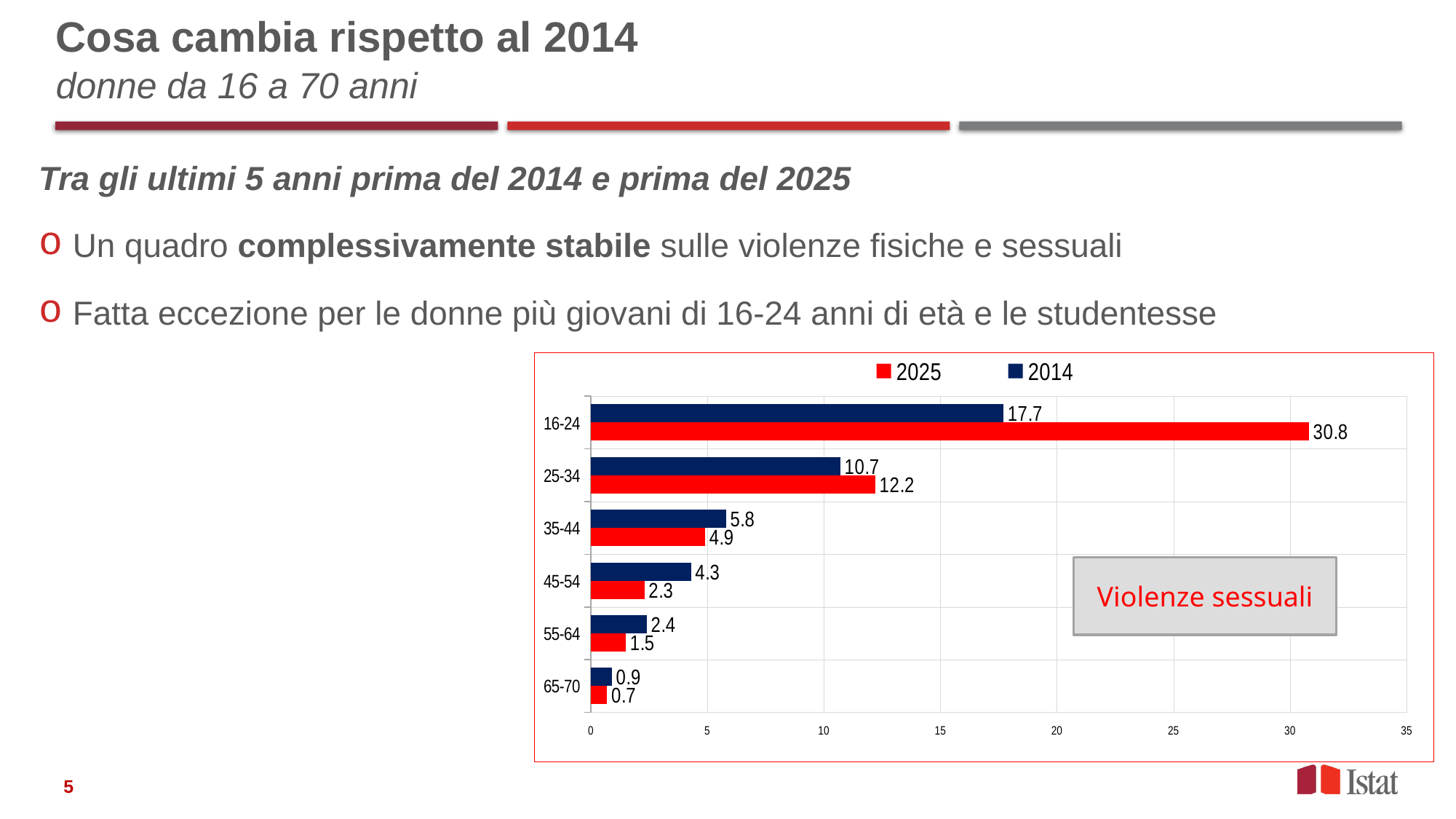
What is the difference between the 2025 and 2014 values for the 16-24 age group? 13.1 Is the 2025 value for the 25-34 age group greater or less than 10? greater Which age group has the highest 2025 value? 16-24 Which age group has the lowest 2014 value? 65-70 For the 35-44 age group, which is larger, the 2014 value or the 2025 value? 2014 What is the 2025 value for the 45-54 age group? 2.3 What kind of chart is shown on the slide? bar chart What is the 2025 value for the 16-24 age group? 30.8 How many series does the legend list? 2 How many age groups are shown on the chart? 6 What is the 2014 value for the 25-34 age group? 10.7 What text appears in the box inside the chart area? Violenze sessuali